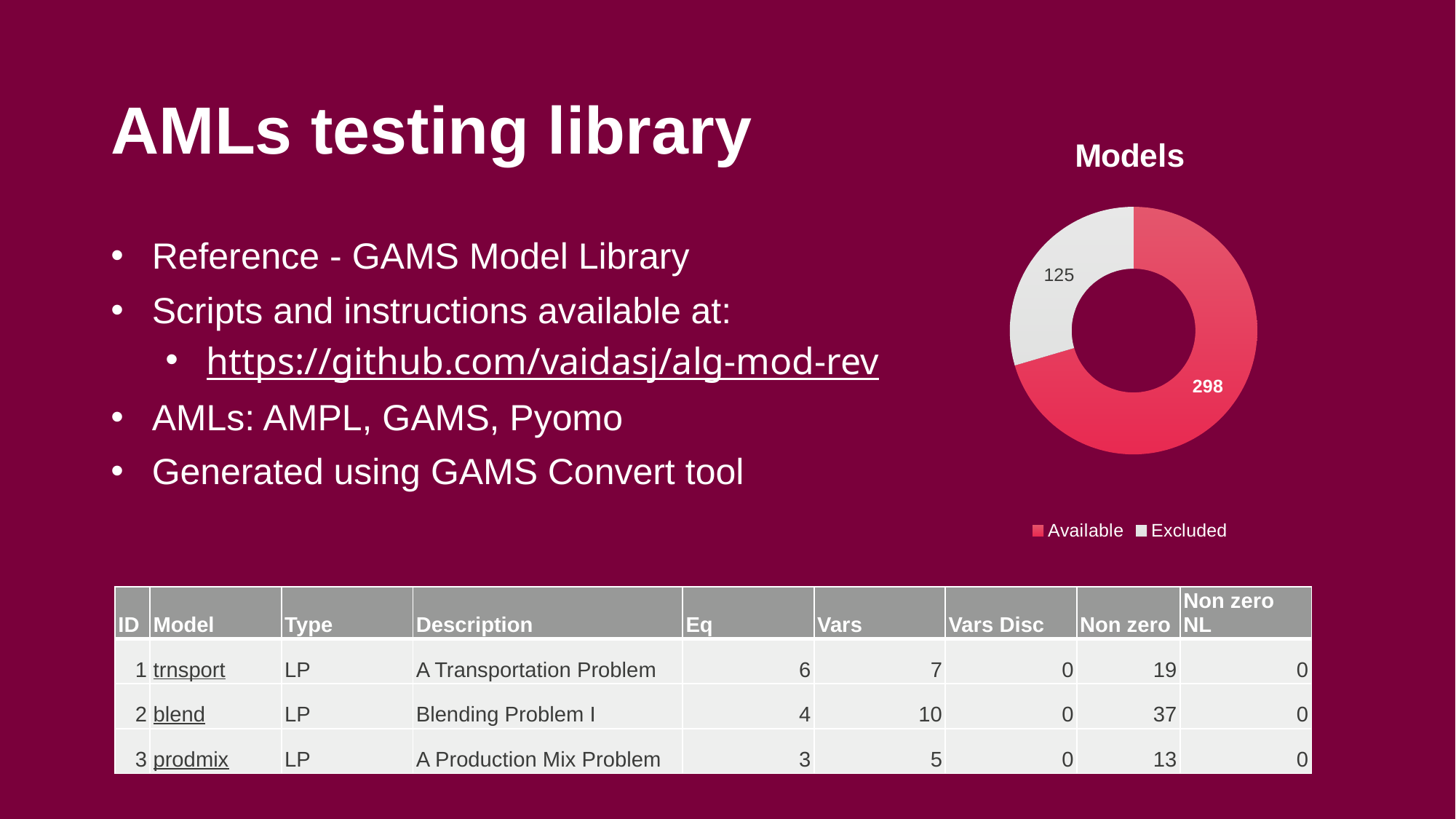
In the Models chart, what is the value for Available? 298 In the Models chart, what is the value for Excluded? 125 What is the title of the chart on the slide? Models In the Models chart, which category is shown in red? Available How many categories does the Models chart show? 2 How many entries does the legend of the Models chart list? 2 What kind of chart is the Models chart? doughnut chart In the Models chart, which is larger, Available or Excluded? Available In the Models chart, what is the total of the Available and Excluded values? 423 In the Models chart, what is the difference between the Available and Excluded values? 173 In the Models chart, which category has the largest value? Available In the Models chart, which category has the smallest value? Excluded